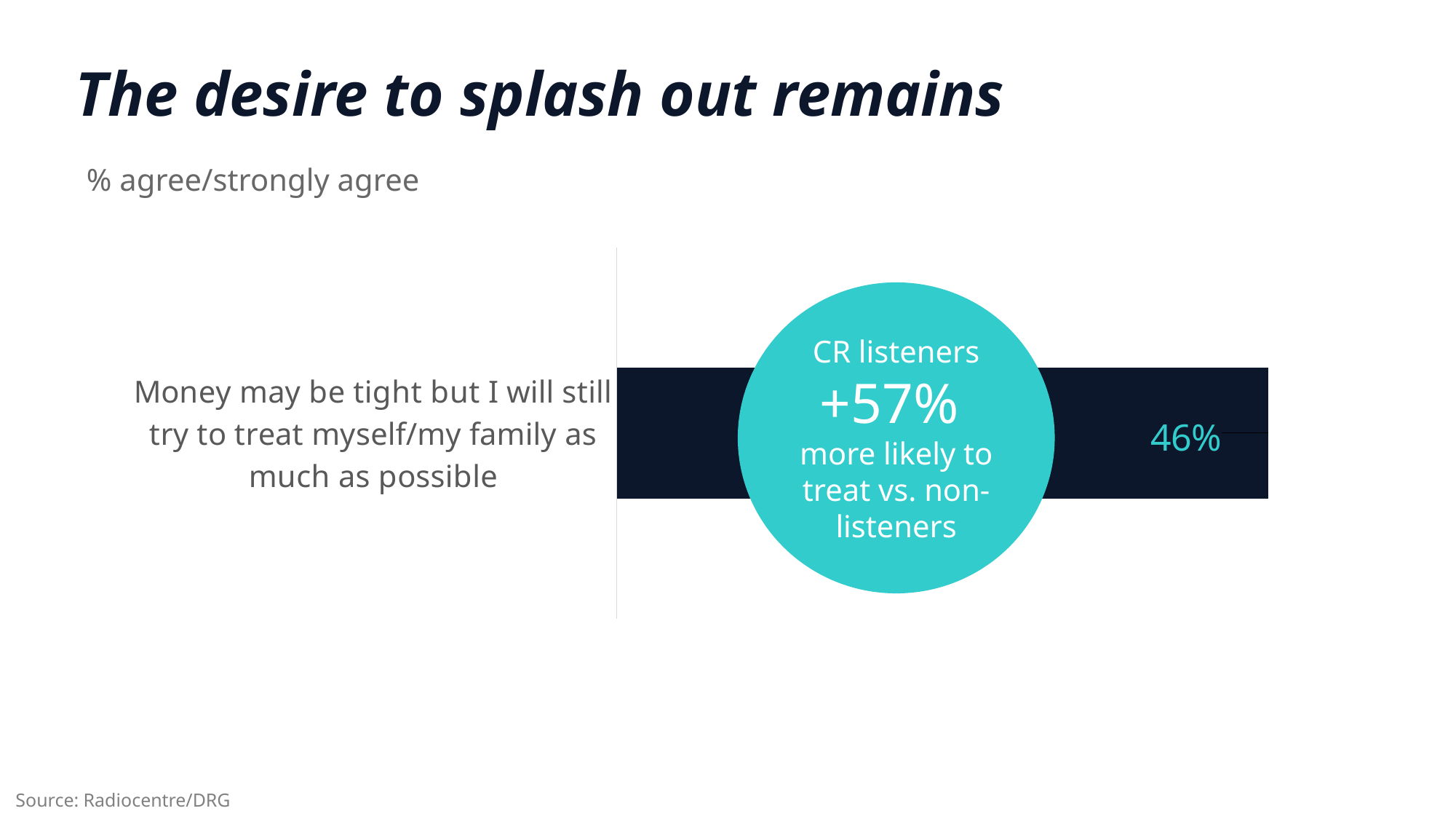
How many categories are plotted in the bar chart? 1 What percentage agree/strongly agree with the statement "Money may be tight but I will still try to treat myself/my family as much as possible"? 46% According to the callout on the chart, how much more likely are CR listeners to treat vs. non-listeners? +57% Is the value for "Money may be tight but I will still try to treat myself/my family as much as possible" greater or less than 50%? less What is the subtitle describing the measure plotted in the chart? % agree/strongly agree What kind of chart is shown on the slide? Bar chart